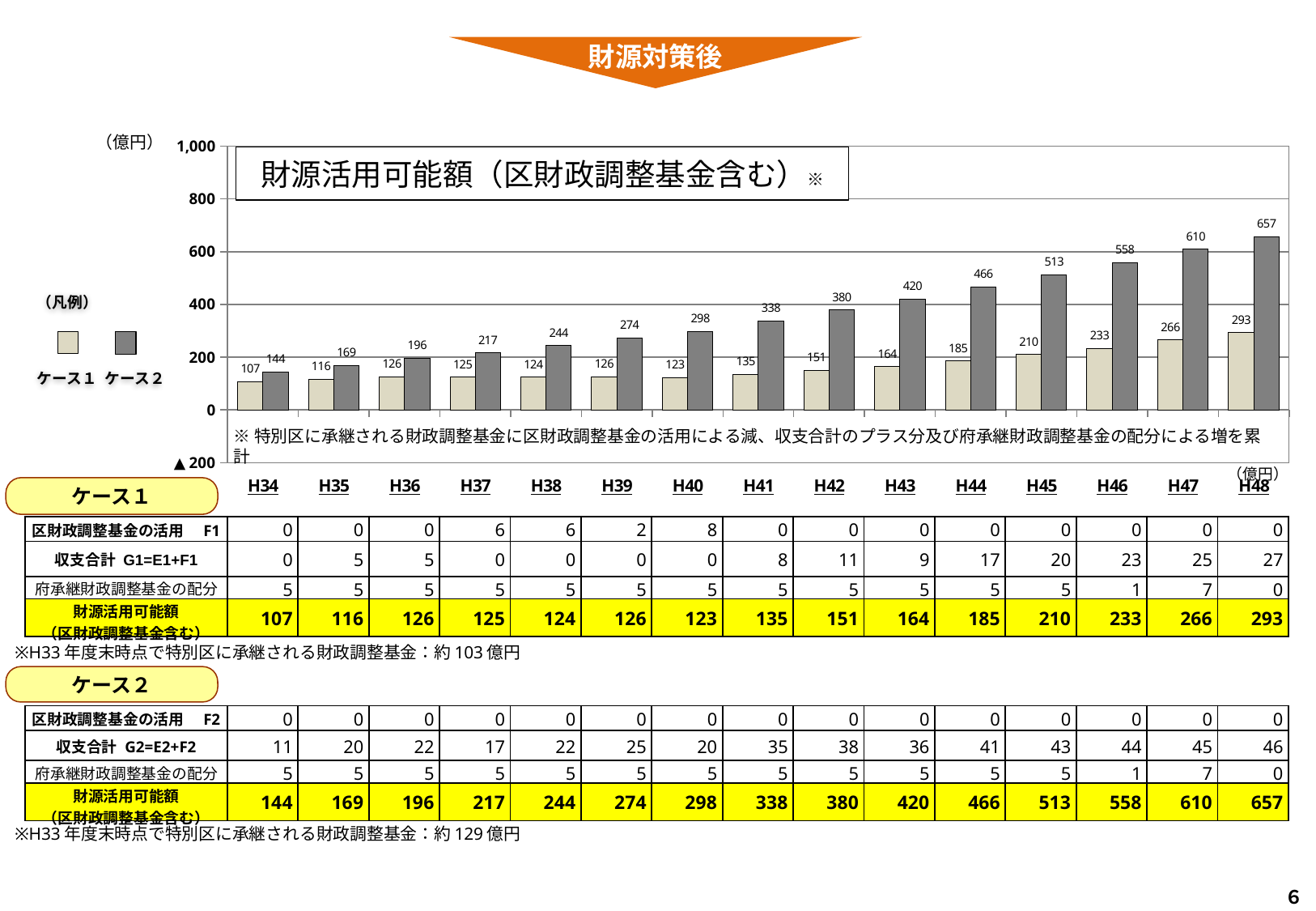
How many series does the chart legend list? 2 What is the value for ケース1 in H44? 185 How many years are shown on the x axis of the chart? 15 Is the value for ケース2 in H45 greater or less than 400? greater Do the ケース2 values rise or fall from H34 to H48? rise What kind of chart is shown on the slide? bar chart In which year is the ケース1 value lowest? H34 What is the value for ケース2 in H40? 298 In which year is the ケース2 value highest? H48 Which is larger: the ケース2 value in H42 or the ケース1 value in H43? ケース2 in H42 What is the value for ケース1 in H48? 293 What is the difference between the ケース2 and ケース1 values in H48? 364